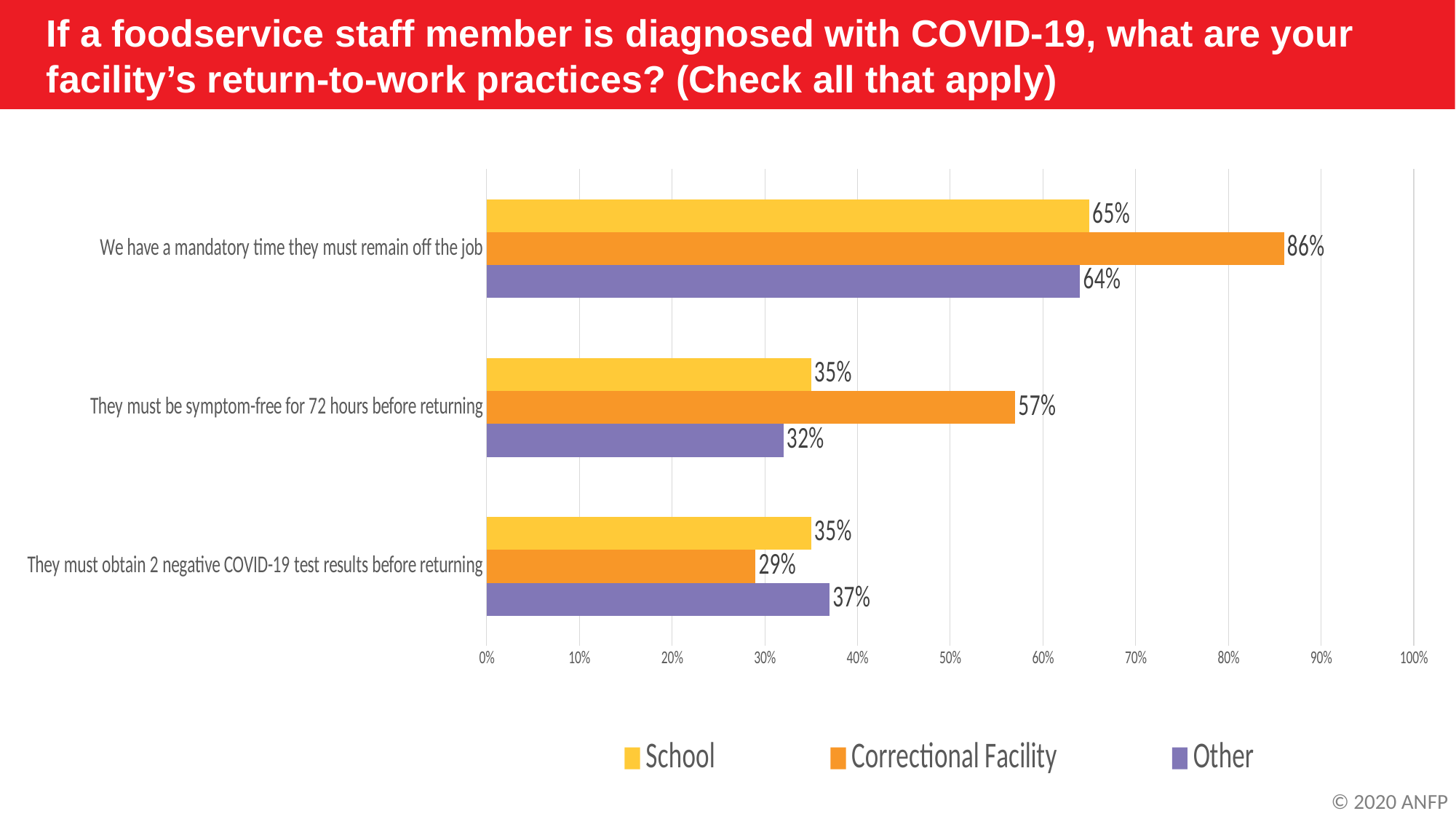
What kind of chart is shown on the slide? Bar chart Is the Correctional Facility value for 'We have a mandatory time they must remain off the job' greater or less than 80%? greater What percentage of Correctional Facility respondents have a mandatory time staff must remain off the job? 86% Which facility type has the highest value for 'They must be symptom-free for 72 hours before returning'? Correctional Facility How many return-to-work practices (categories) are shown on the chart? 3 How many series does the legend list? 3 For 'They must be symptom-free for 72 hours before returning', which is larger: the School value or the Other value? School What is the difference between the Correctional Facility and School values for 'We have a mandatory time they must remain off the job'? 21% Which colour represents the Other series in the legend? Purple What is the School value for 'They must be symptom-free for 72 hours before returning'? 35% Which facility type has the lowest value for 'They must obtain 2 negative COVID-19 test results before returning'? Correctional Facility What is the Other value for 'They must obtain 2 negative COVID-19 test results before returning'? 37%